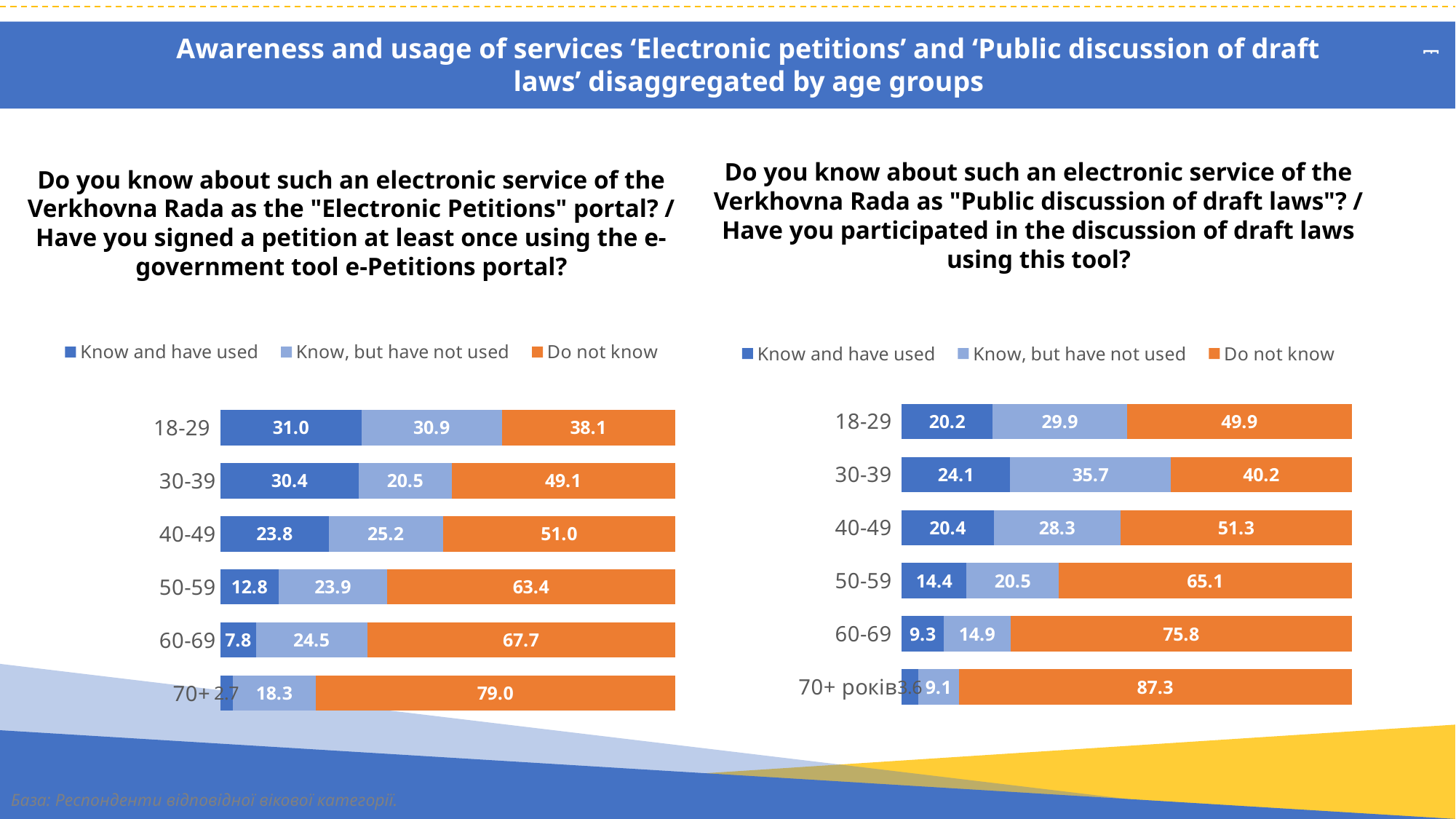
In the right chart (Public discussion of draft laws), which is larger: the 'Know and have used' value for 30-39 or for 40-49? 30-39 In the left chart (Electronic Petitions), which age group has the highest 'Know and have used' value? 18-29 Which colour represents 'Do not know' in both charts? Orange What type of chart is the left chart (Electronic Petitions)? Stacked bar chart In the left chart (Electronic Petitions), what is the total of the stacked bar for the 50-59 age group? 100.1 In the right chart (Public discussion of draft laws), which age group has the lowest 'Do not know' value? 30-39 In the right chart (Public discussion of draft laws), what is the 'Know, but have not used' value for the 30-39 age group? 35.7 How many series does the legend of the right chart (Public discussion of draft laws) list? 3 In the left chart (Electronic Petitions), what is the 'Do not know' value for the 18-29 age group? 38.1 In the right chart (Public discussion of draft laws), does the 'Do not know' value rise or fall as the age groups go from 40-49 to 70+? Rise How many age groups are shown in the left chart (Electronic Petitions)? 6 In the left chart (Electronic Petitions), what is the difference between the 'Do not know' values for the 70+ and 18-29 age groups? 40.9